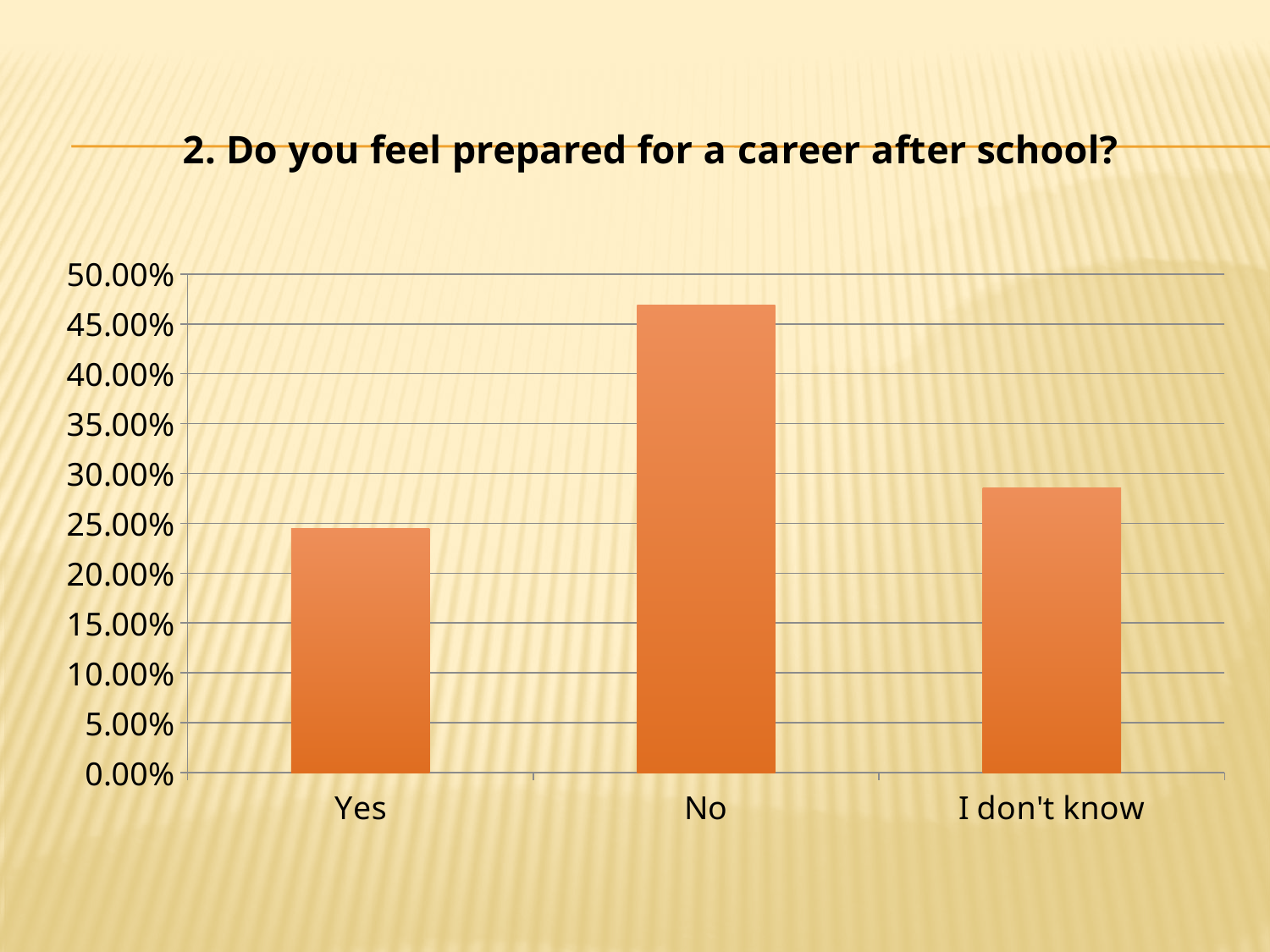
Which category has the lowest value in the chart? Yes Which is larger, the value for "No" or the value for "Yes"? No Is the value for "I don't know" greater or less than 25.00%? greater What is the title of the chart? 2. Do you feel prepared for a career after school? What kind of chart is shown on the slide? bar chart Which is larger, the value for "I don't know" or the value for "Yes"? I don't know Is the value for "Yes" greater or less than 20.00%? greater How many categories are shown on the x axis of the chart? 3 Is the value for "Yes" greater or less than 30.00%? less What is the highest value shown on the y axis of the chart? 50.00% Which category has the highest value in the chart? No